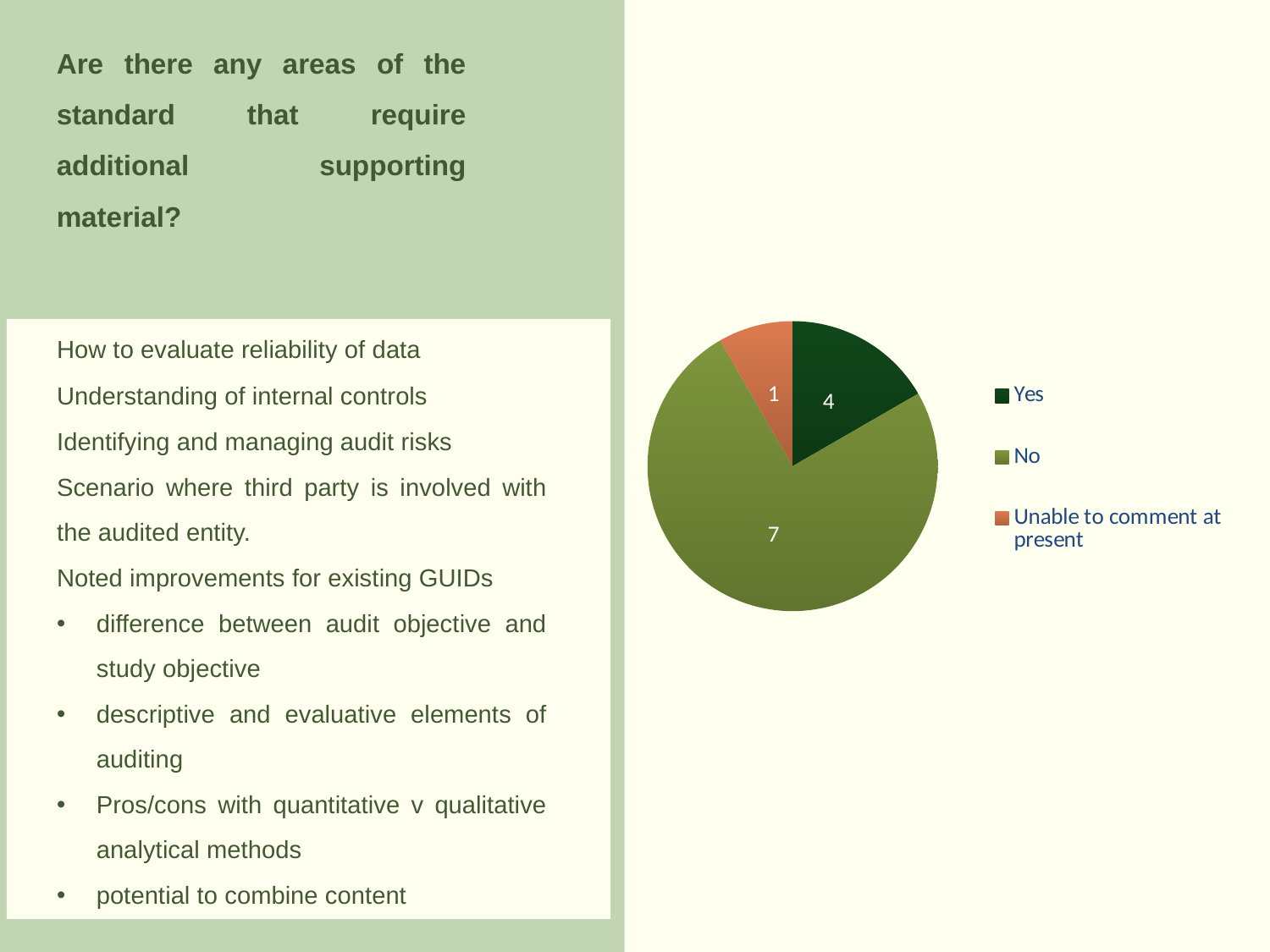
What is the value for the "Yes" slice? 4 How many slices does the pie chart have? 3 What is the value for the "Unable to comment at present" slice? 1 Which category has the largest slice? No What is the difference between the "No" and "Yes" values? 3 How many entries does the legend list? 3 Which category has the smallest slice? Unable to comment at present What colour is the "Unable to comment at present" slice? orange What is the value for the "No" slice? 7 What kind of chart is shown on the slide? pie chart What is the total of all slices in the pie chart? 12 Which is larger, the value for "Yes" or the value for "Unable to comment at present"? Yes